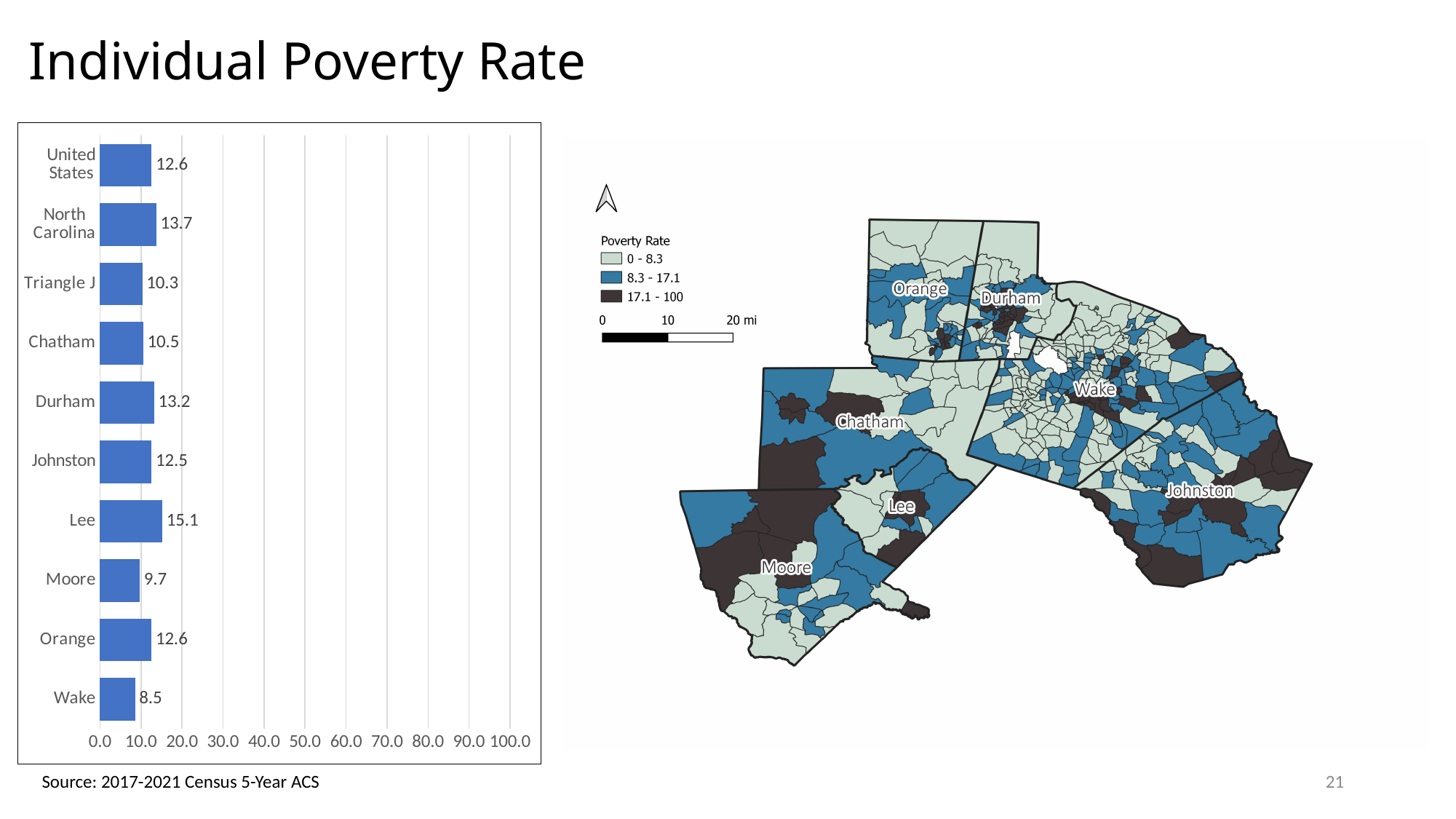
What is the difference between the values for Lee and Wake in the bar chart? 6.6 What kind of chart is used on the left side of the slide? bar chart What is the value for Wake in the bar chart? 8.5 What is the individual poverty rate shown for Lee in the bar chart? 15.1 How much higher is North Carolina's value than the United States value in the bar chart? 1.1 Is the value for Moore in the bar chart greater or less than 10.0? less Which category has the lowest value in the bar chart? Wake How many categories are shown in the bar chart? 10 In the bar chart, which is larger: the value for Durham or the value for Johnston? Durham How many poverty rate classes does the map legend list? 3 What value does the bar chart show for North Carolina? 13.7 Which category has the highest value in the bar chart? Lee